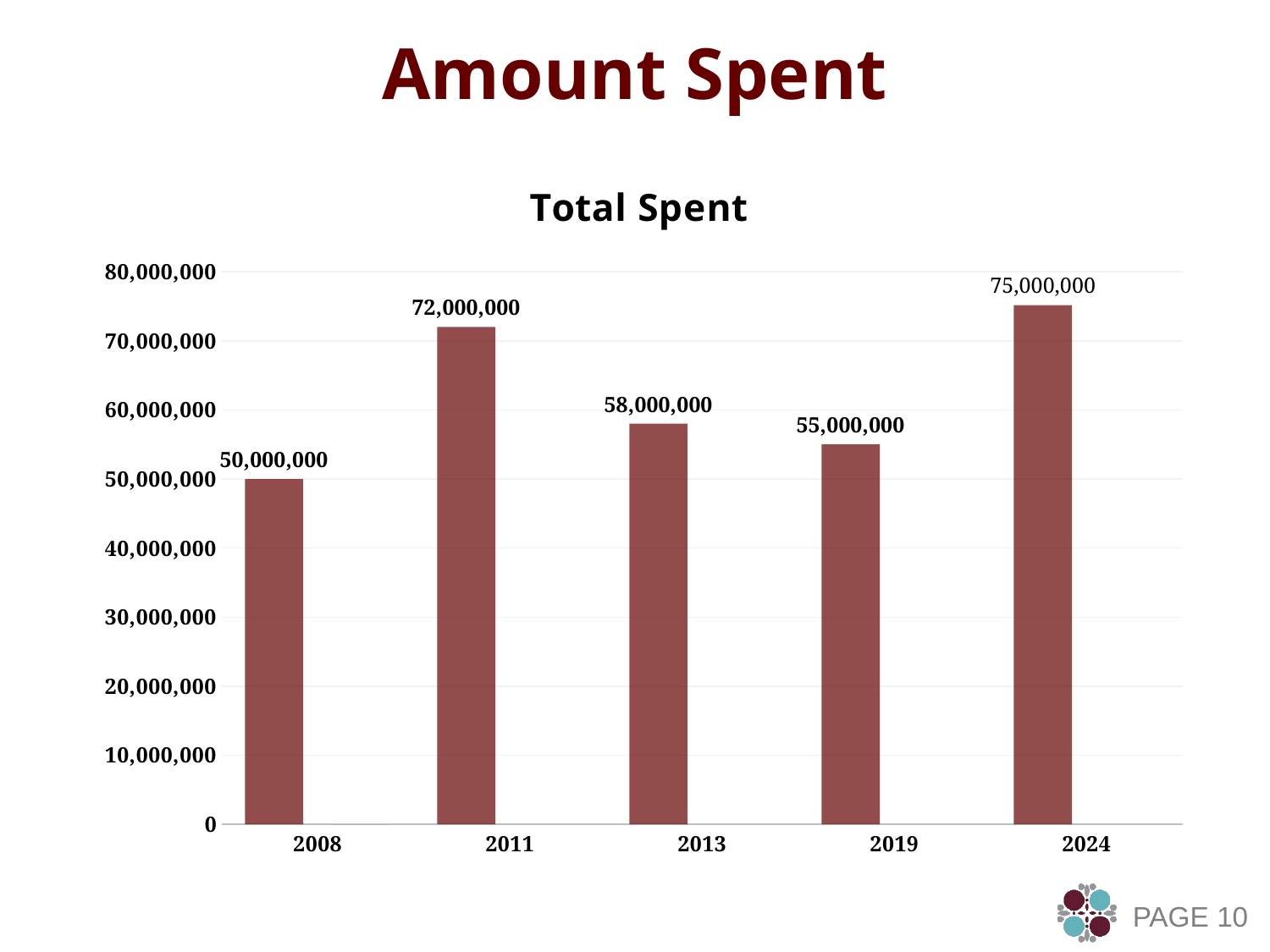
What kind of chart is shown on the slide? bar chart Which is larger, the value for 2013 or the value for 2019? 2013 What is the title of the chart? Total Spent Which year has the highest total spent? 2024 What is the value for 2019? 55,000,000 How many years are shown on the x axis? 5 Which year has the lowest total spent? 2008 What is the value for 2011? 72,000,000 What is the difference between the values for 2011 and 2013? 14,000,000 Is the value for 2011 greater or less than 70,000,000? greater What is the value for 2008? 50,000,000 What is the difference between the values for 2024 and 2008? 25,000,000